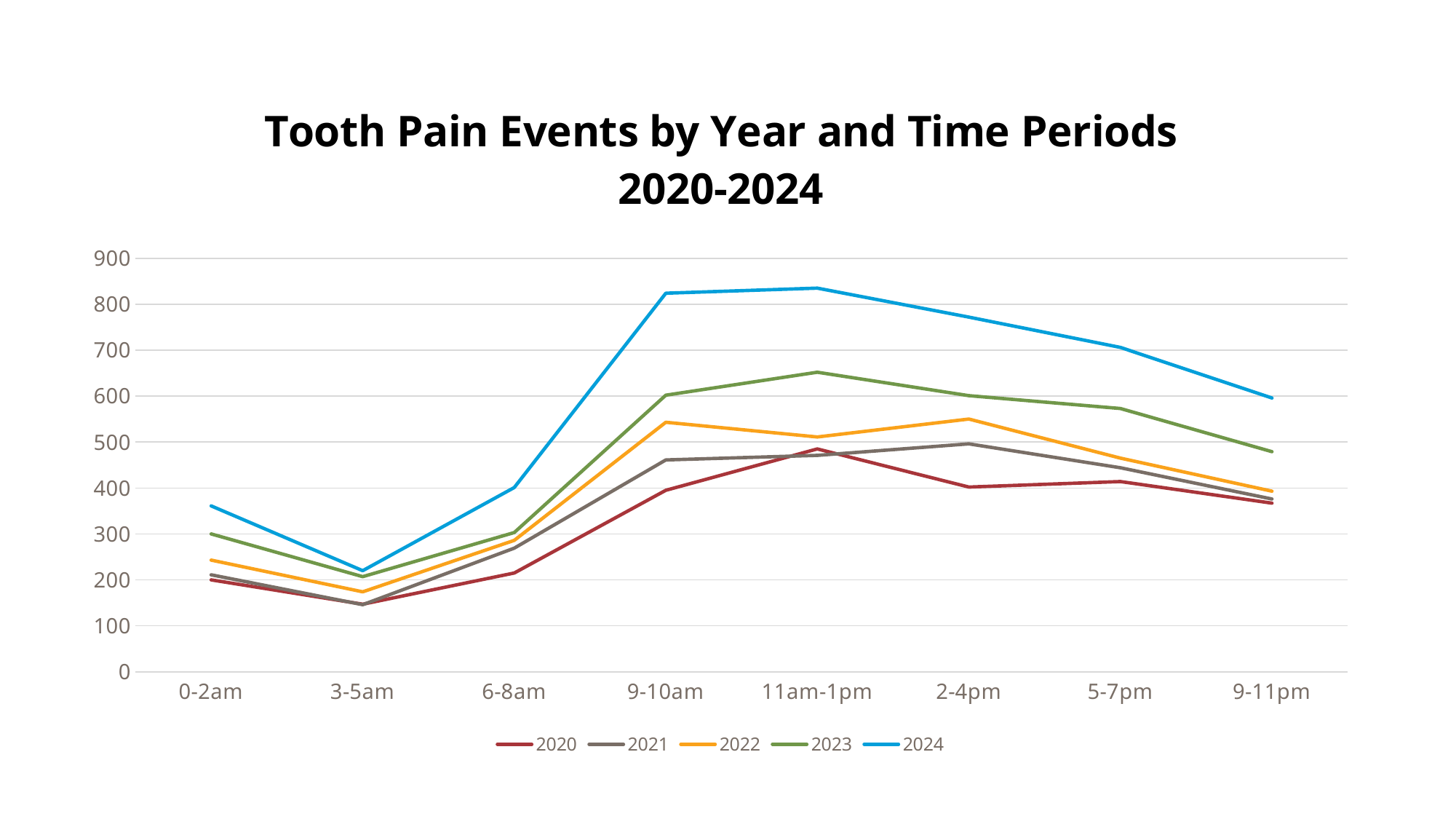
How many time periods are shown along the x axis? 8 Which time period has the lowest value for the 2024 series? 3-5am Do the values for the 2024 series rise or fall from 11am-1pm to 9-11pm? fall Is the value for 2024 at 9-10am greater or less than 700? greater What kind of chart is shown on the slide? line chart At 9-10am, which series has the larger value, 2024 or 2020? 2024 Which time period has the lowest value for the 2023 series? 3-5am Is the value for 2023 at 11am-1pm greater or less than 600? greater What is the title of the chart? Tooth Pain Events by Year and Time Periods 2020-2024 Is the value for 2024 at 9-11pm greater or less than 500? greater How many series does the legend list? 5